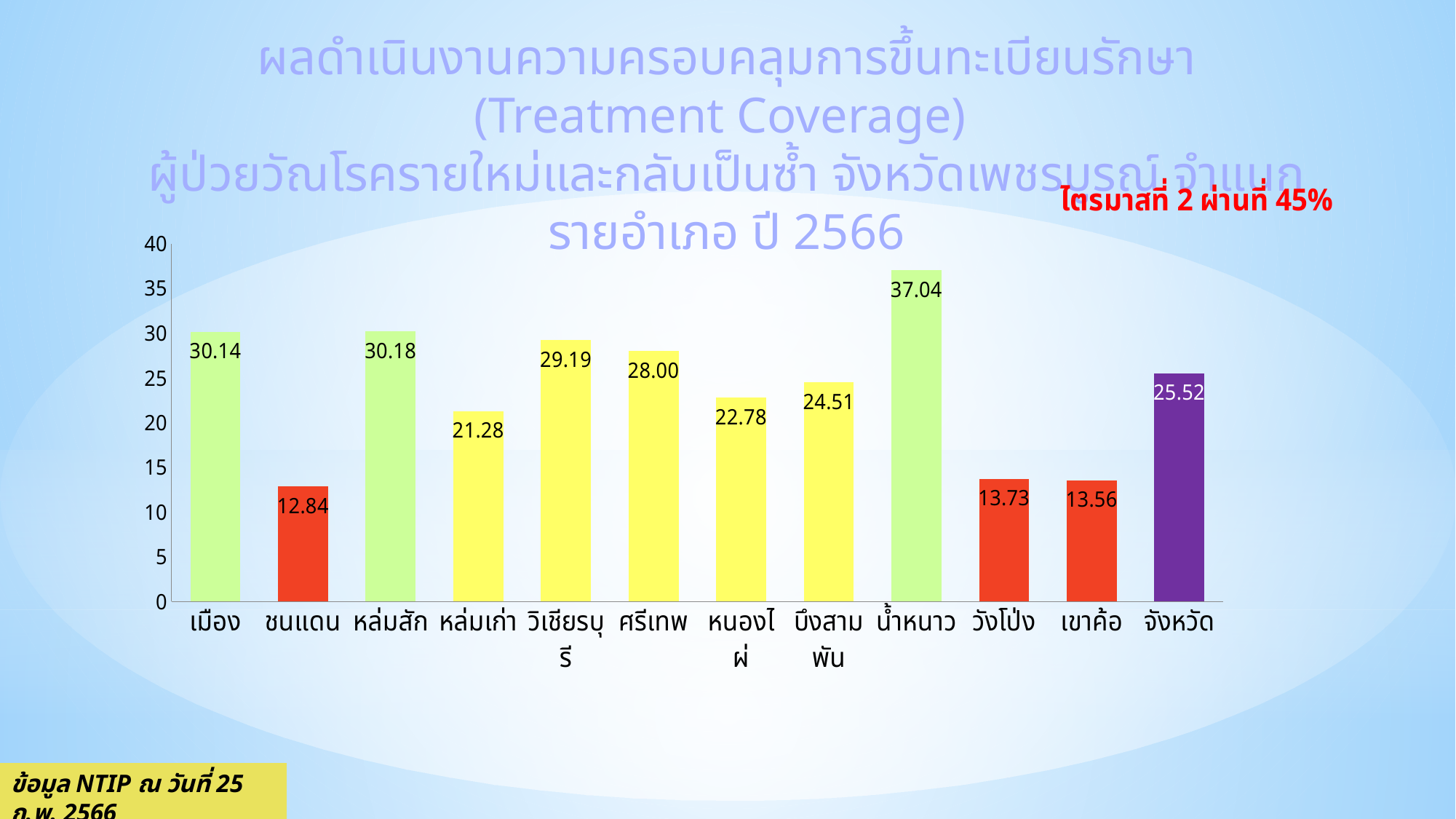
What colour is the bar for จังหวัด? purple How many categories are shown on the x axis? 12 Which is larger, the value for ศรีเทพ or the value for หนองไผ่? ศรีเทพ Is the value for บึงสามพัน greater or less than 25? less What is the value for จังหวัด? 25.52 What is the value for ชนแดน? 12.84 Which category has the lowest value? ชนแดน Which category has the highest value? น้ำหนาว What is the difference between the values for วังโป่ง and เขาค้อ? 0.17 What is the difference between the values for น้ำหนาว and ชนแดน? 24.20 What is the value for น้ำหนาว? 37.04 What kind of chart is shown on the slide? bar chart